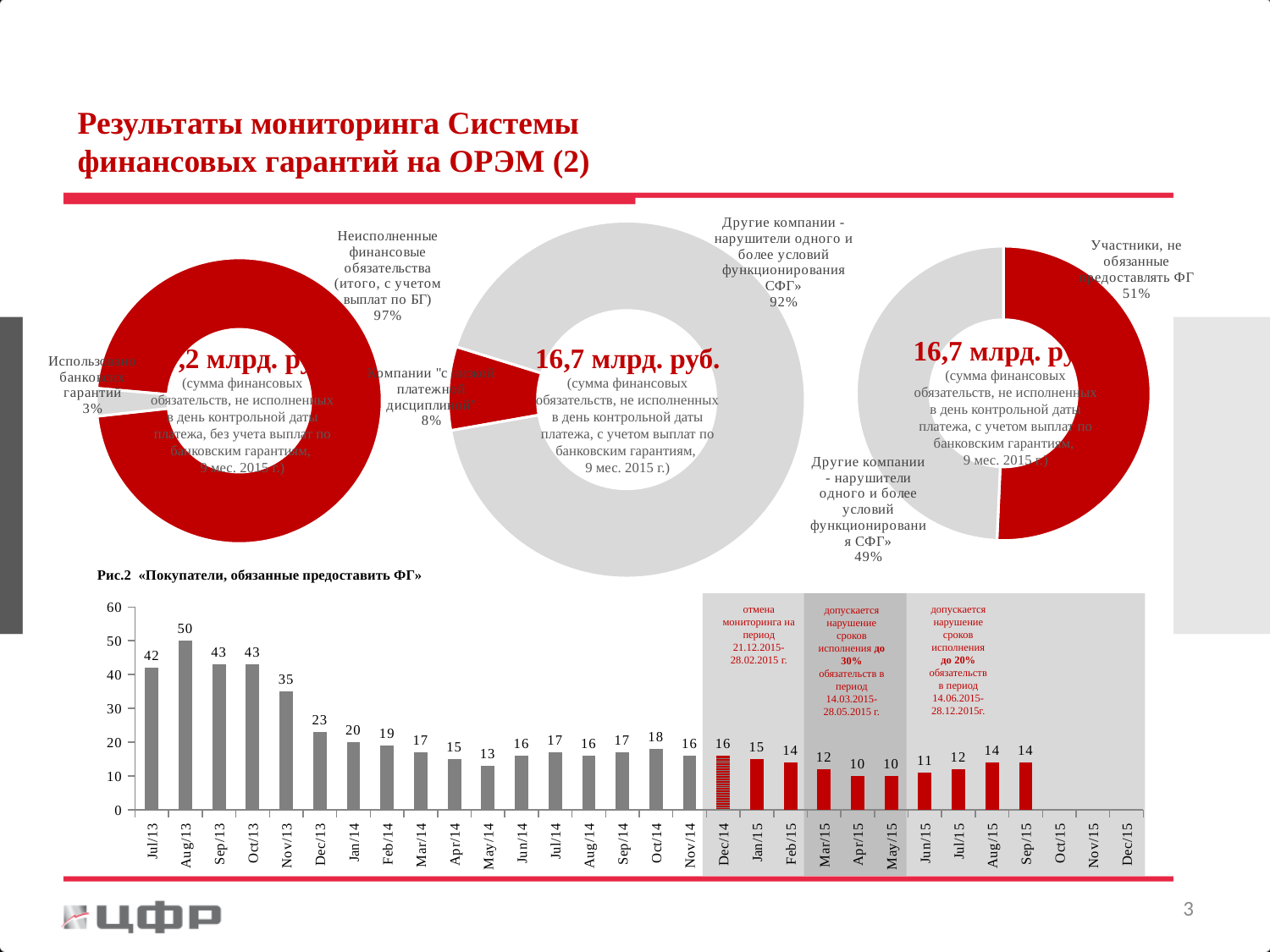
In the bar chart «Покупатели, обязанные предоставить ФГ», what is the value for Apr/15? 10 In the bar chart «Покупатели, обязанные предоставить ФГ», how many months have a plotted bar with a value? 27 In the right donut chart, what share is labelled «Участники, не обязанные предоставлять ФГ»? 51% In the bar chart «Покупатели, обязанные предоставить ФГ», what is the value for Aug/13? 50 In the bar chart «Покупатели, обязанные предоставить ФГ», is the value for Sep/13 greater or less than 40? greater In the bar chart «Покупатели, обязанные предоставить ФГ», which month has the highest value? Aug/13 In the bar chart «Покупатели, обязанные предоставить ФГ», which is larger, the value for Dec/13 or the value for Jan/14? Dec/13 In the left donut chart, what share is labelled «Использовано банковских гарантий»? 3% In the bar chart «Покупатели, обязанные предоставить ФГ», what is the difference between the values for Jul/13 and Nov/13? 7 What kind of chart is «Покупатели, обязанные предоставить ФГ»? bar chart In the middle donut chart, what share is labelled «Компании "с низкой платежной дисциплиной"»? 8% In the bar chart «Покупатели, обязанные предоставить ФГ», do the values generally rise or fall from Jul/13 to May/14? fall